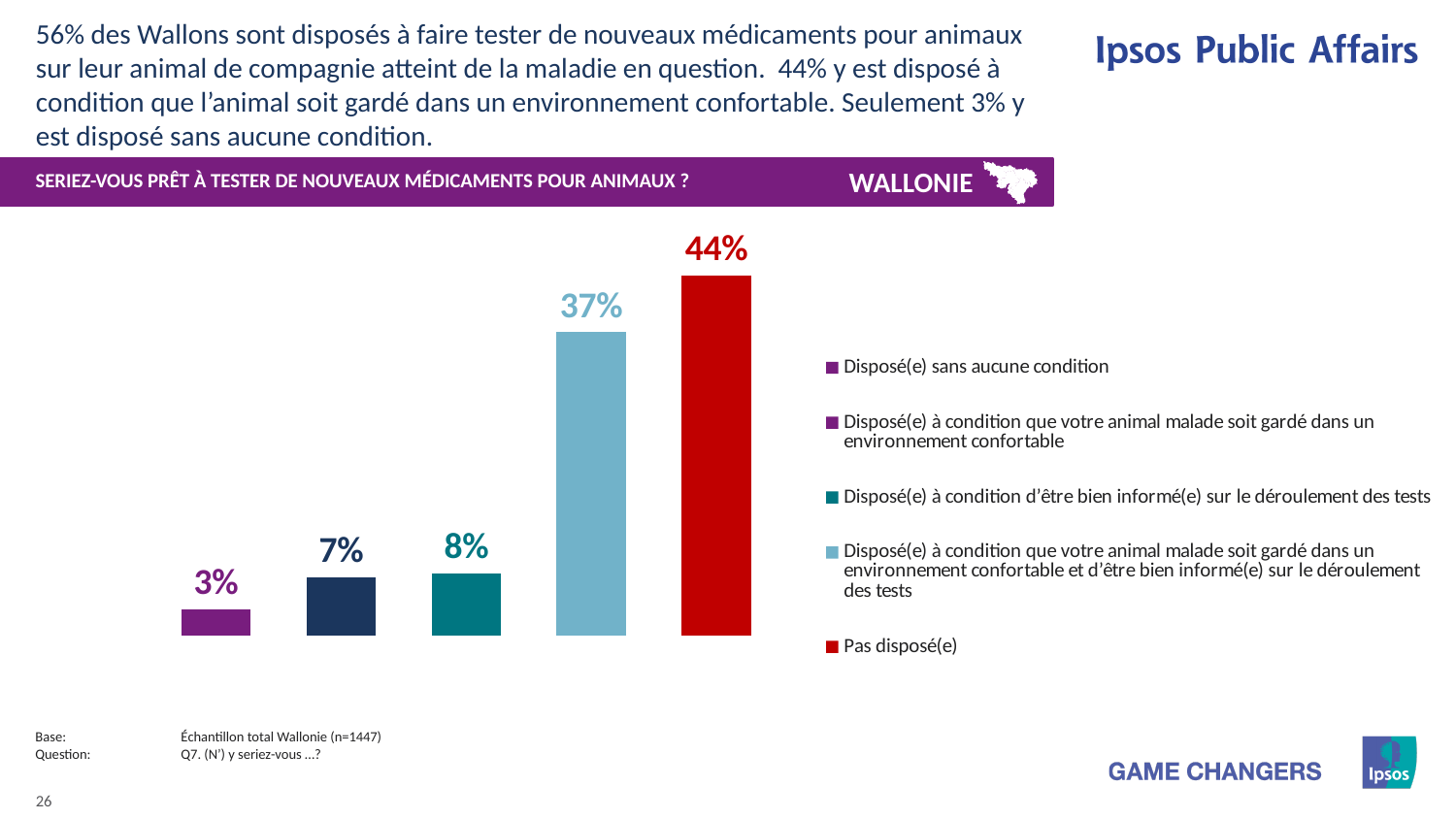
What percentage of respondents are 'Disposé(e) sans aucune condition'? 3% What percentage of respondents are 'Pas disposé(e)'? 44% How many bars are shown in the chart? 5 Which is larger: the value for 'Disposé(e) à condition que votre animal malade soit gardé dans un environnement confortable' or the value for 'Disposé(e) à condition d'être bien informé(e) sur le déroulement des tests'? Disposé(e) à condition d'être bien informé(e) sur le déroulement des tests What type of chart is shown on the slide? Bar chart What percentage of respondents are 'Disposé(e) à condition que votre animal malade soit gardé dans un environnement confortable et d'être bien informé(e) sur le déroulement des tests'? 37% What colour is the bar for 'Pas disposé(e)'? Red What is the difference between the 'Pas disposé(e)' value and the value for those willing on condition of both a comfortable environment and being well informed? 7% What percentage of respondents are 'Disposé(e) à condition d'être bien informé(e) sur le déroulement des tests'? 8% Which response category has the highest value in the chart? Pas disposé(e) Which response category has the lowest value in the chart? Disposé(e) sans aucune condition How many entries does the legend list? 5